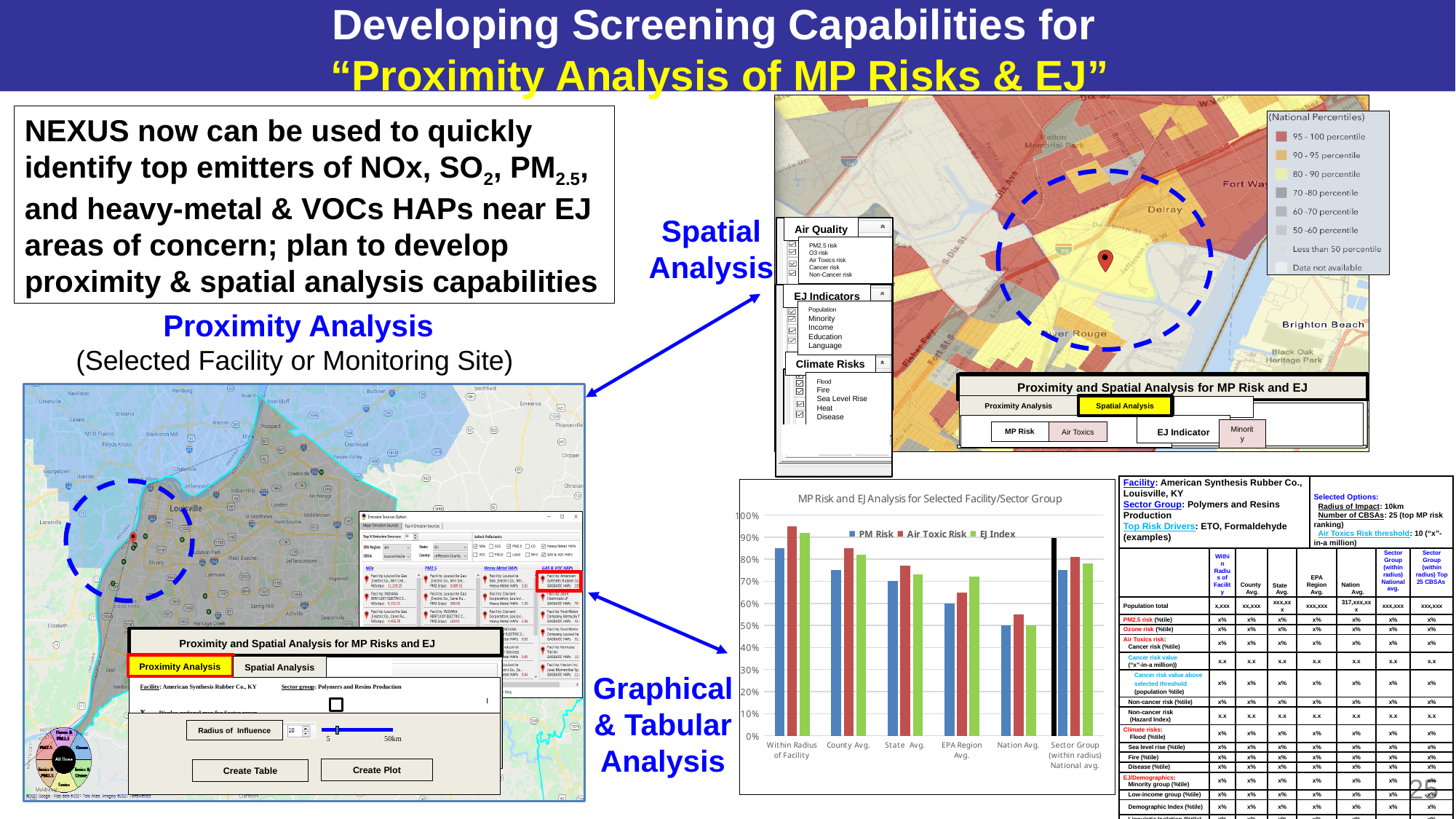
How many series does the chart's legend list? 3 Which category has the highest Air Toxic Risk value? Within Radius of Facility Which is larger, the PM Risk value for Within Radius of Facility or for County Avg.? Within Radius of Facility How many categories are shown along the x axis of the chart? 6 Which category has the lowest PM Risk value? Nation Avg. What kind of chart is shown on the slide? bar chart Which series in the chart is shown in green? EJ Index Is the Air Toxic Risk value for Nation Avg. greater or less than 60%? less What is the title of the chart on the slide? MP Risk and EJ Analysis for Selected Facility/Sector Group Is the PM Risk value for Within Radius of Facility greater or less than 80%? greater Is the Air Toxic Risk value for Within Radius of Facility greater or less than 90%? greater Does the PM Risk value rise or fall from Within Radius of Facility to Nation Avg.? fall